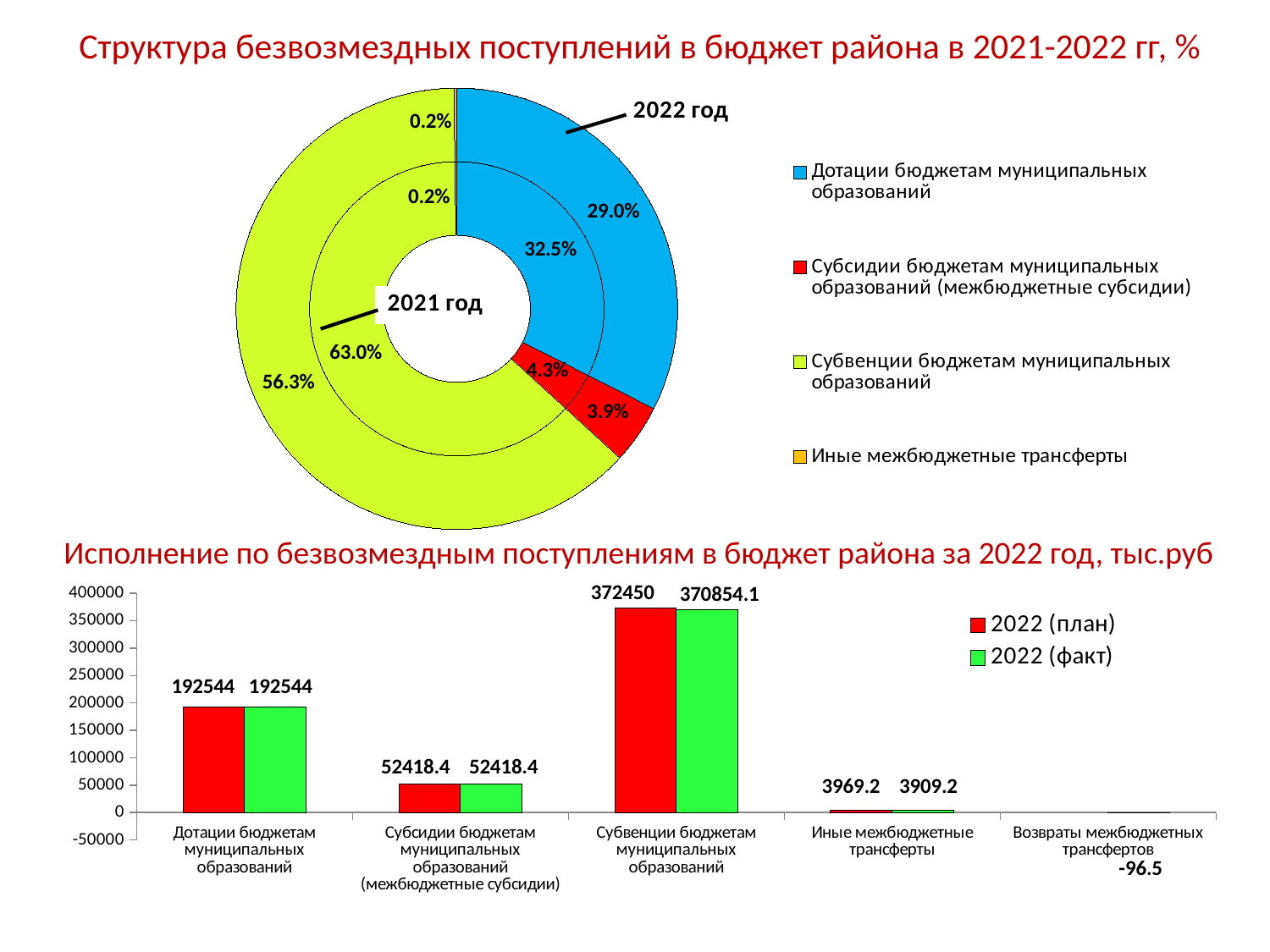
In the bottom bar chart, which category has the highest 2022 (факт) value? Субвенции бюджетам муниципальных образований How many categories does the legend of the top doughnut chart list? 4 In the top doughnut chart, by how many percentage points did the share of Субвенции бюджетам муниципальных образований change from 2021 (63.0%) to 2022 (56.3%)? 6.7 In the top doughnut chart, what share do Субсидии бюджетам муниципальных образований have in 2022? 3.9% In the bottom bar chart, what is the difference between the 2022 (план) and 2022 (факт) values for Субвенции бюджетам муниципальных образований? 1595.9 In the top doughnut chart, which category has the smallest share in 2022? Иные межбюджетные трансферты What type of chart is the bottom chart on the slide? Bar chart In the bottom bar chart, what is the 2022 (план) value for Субвенции бюджетам муниципальных образований? 372450 In the top doughnut chart, what share do Дотации бюджетам муниципальных образований have in 2021? 32.5% In the bottom bar chart, what is the 2022 (факт) value for Иные межбюджетные трансферты? 3909.2 In the top doughnut chart, what share do Субвенции бюджетам муниципальных образований have in 2022? 56.3% In the top doughnut chart, which category has the largest share in 2021? Субвенции бюджетам муниципальных образований